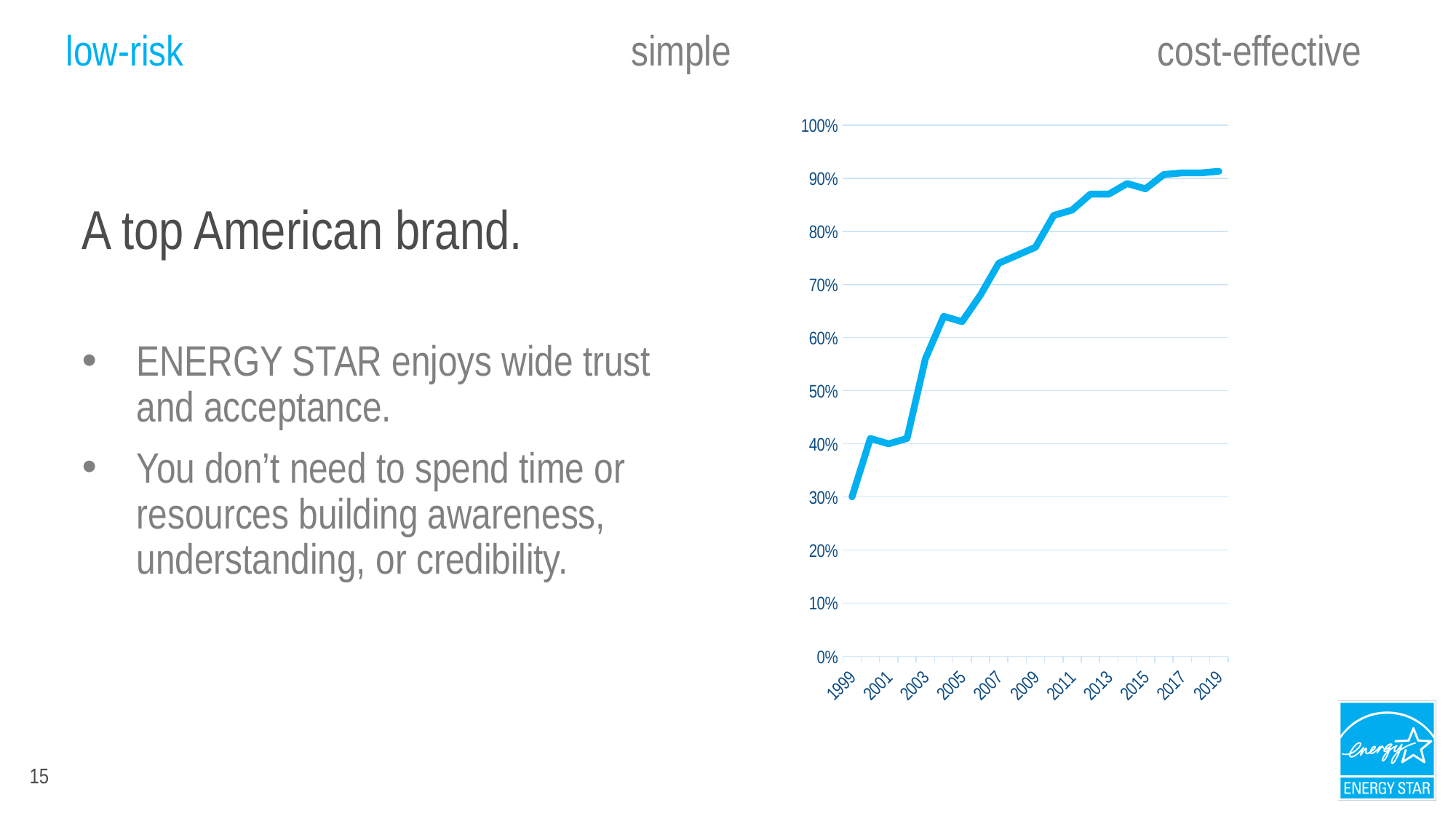
Is the value for 2019 greater or less than 90%? greater What kind of chart is shown on the slide? line chart Is the value for 2007 greater or less than 70%? greater How many year labels are shown on the x axis? 11 Which year has the lowest value in the chart? 1999 Is the value for 2001 greater or less than 50%? less What is the highest value shown on the y axis? 100% Do the values in the chart generally rise or fall from 1999 to 2019? rise Which year has the larger value, 2003 or 2013? 2013